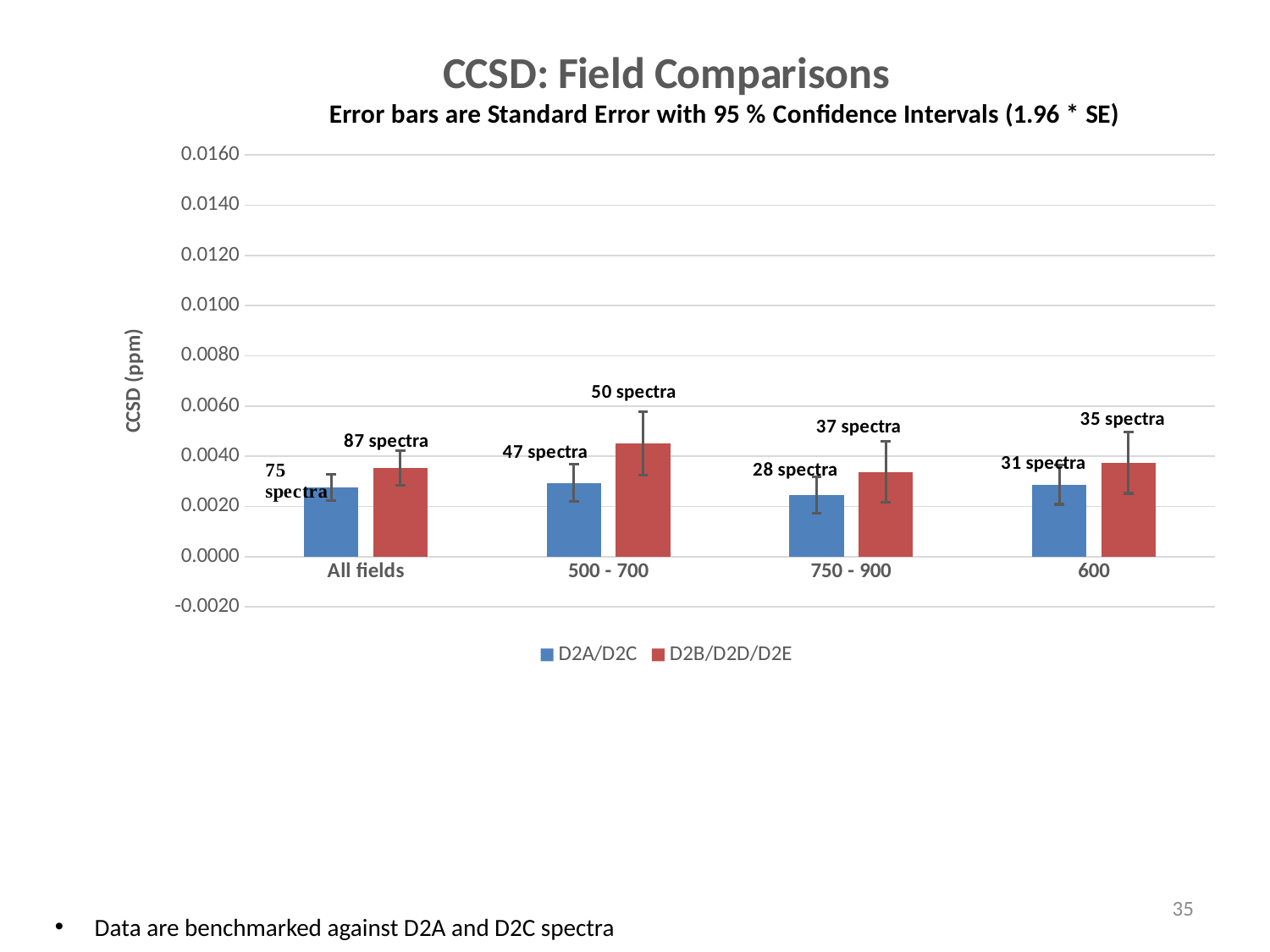
Is the D2A/D2C value for All fields greater or less than 0.0040? less What kind of chart is shown on the slide? bar chart Is the D2A/D2C value for 500 - 700 greater or less than 0.0020? greater For the 750 - 900 category, which series has the larger value, D2A/D2C or D2B/D2D/D2E? D2B/D2D/D2E What are the two legend entries of the chart? D2A/D2C and D2B/D2D/D2E How many categories are shown on the x axis? 4 Which is larger: the D2B/D2D/D2E value for 500 - 700 or the D2B/D2D/D2E value for 600? 500 - 700 Is the D2B/D2D/D2E value for 500 - 700 greater or less than 0.0040? greater How many series does the legend list? 2 What is the label of the y axis? CCSD (ppm) Which category has the highest D2B/D2D/D2E bar? 500 - 700